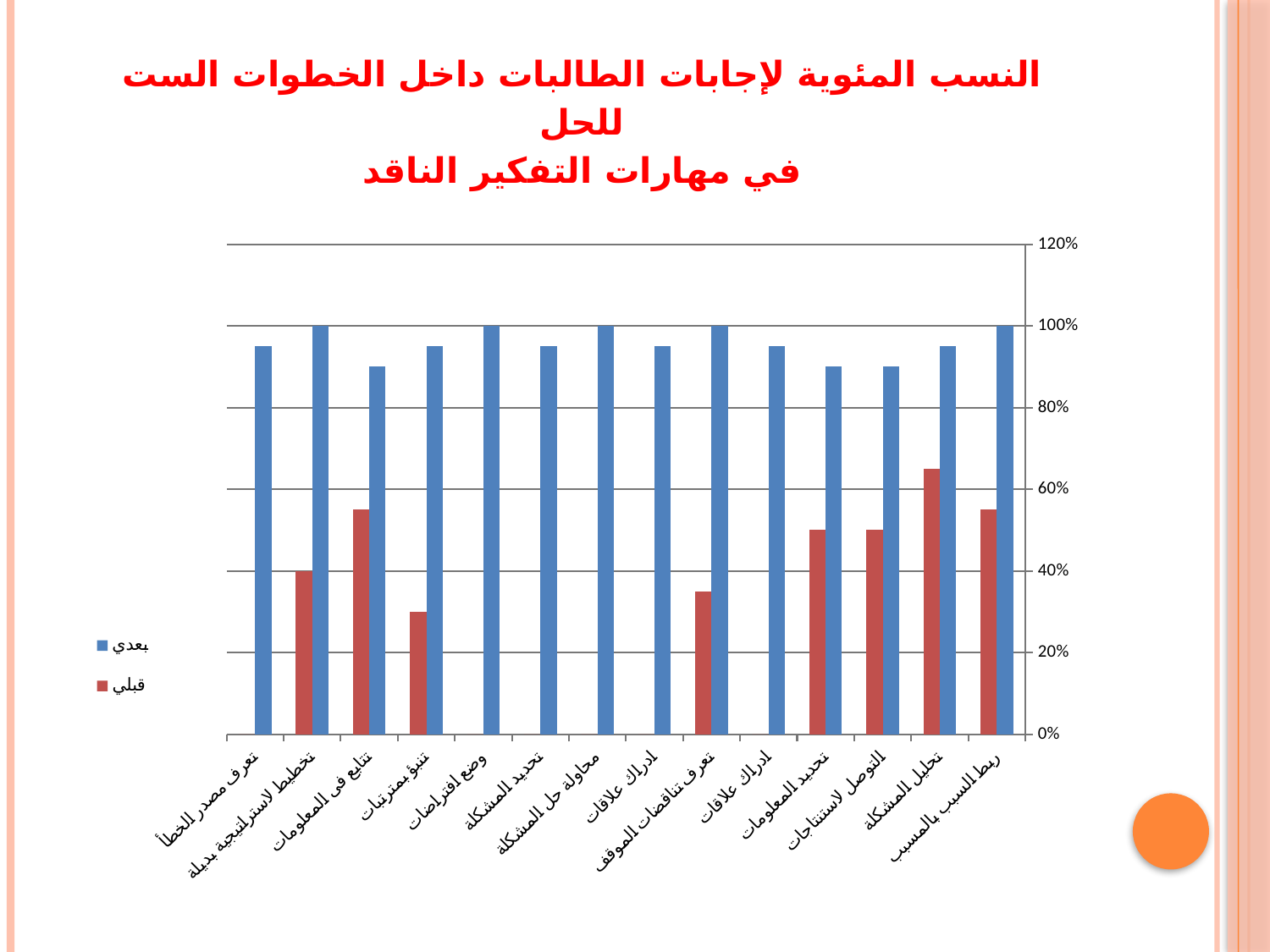
How many categories are shown on the x axis? 14 Which is larger: the قبلي value for تحليل المشكلة or the قبلي value for تخطيط لاستراتيجية بديلة? تحليل المشكلة Which category has the highest قبلي value? تحليل المشكلة How many series does the legend list? 2 Is the قبلي value for تنبؤ بمترتبات greater or less than 40%? less What is the بعدي value for وضع افتراضات? 100% What is the بعدي value for ربط السبب بالمسبب? 100% Which colour represents the بعدي series? blue What is the قبلي value for تخطيط لاستراتيجية بديلة? 40% Is the قبلي value for تتابع في المعلومات greater or less than 40%? greater What are the two series named in the legend? بعدي and قبلي What kind of chart is shown on the slide? bar chart